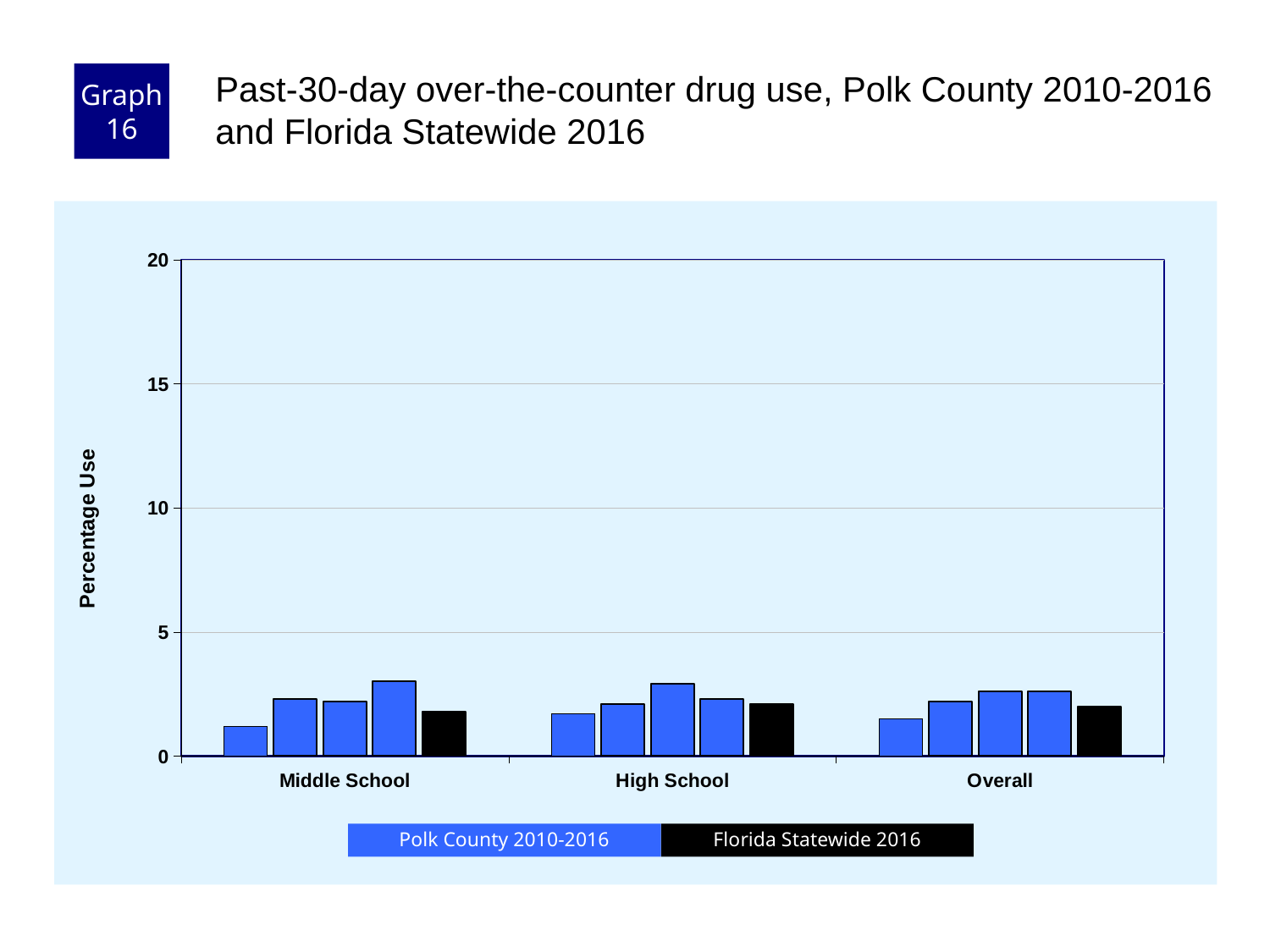
What is the highest value shown on the y axis? 20 How many categories are shown along the x axis? 3 Is the value for Florida Statewide 2016 in the Middle School group greater or less than 5? less What kind of chart is shown on the slide? bar chart In the Middle School group, which bar is the lowest? the first Polk County bar How many series does the legend list? 2 Which colour represents Florida Statewide 2016 in the legend? black In the Middle School group, which is larger: the first Polk County bar or the Florida Statewide 2016 bar? Florida Statewide 2016 In the Middle School group, which Polk County bar is the tallest? the fourth (last) Polk County bar Is the value for Florida Statewide 2016 in the High School group greater or less than 5? less Are any of the bars in the Overall group greater than 5? No What is the label of the y axis? Percentage Use